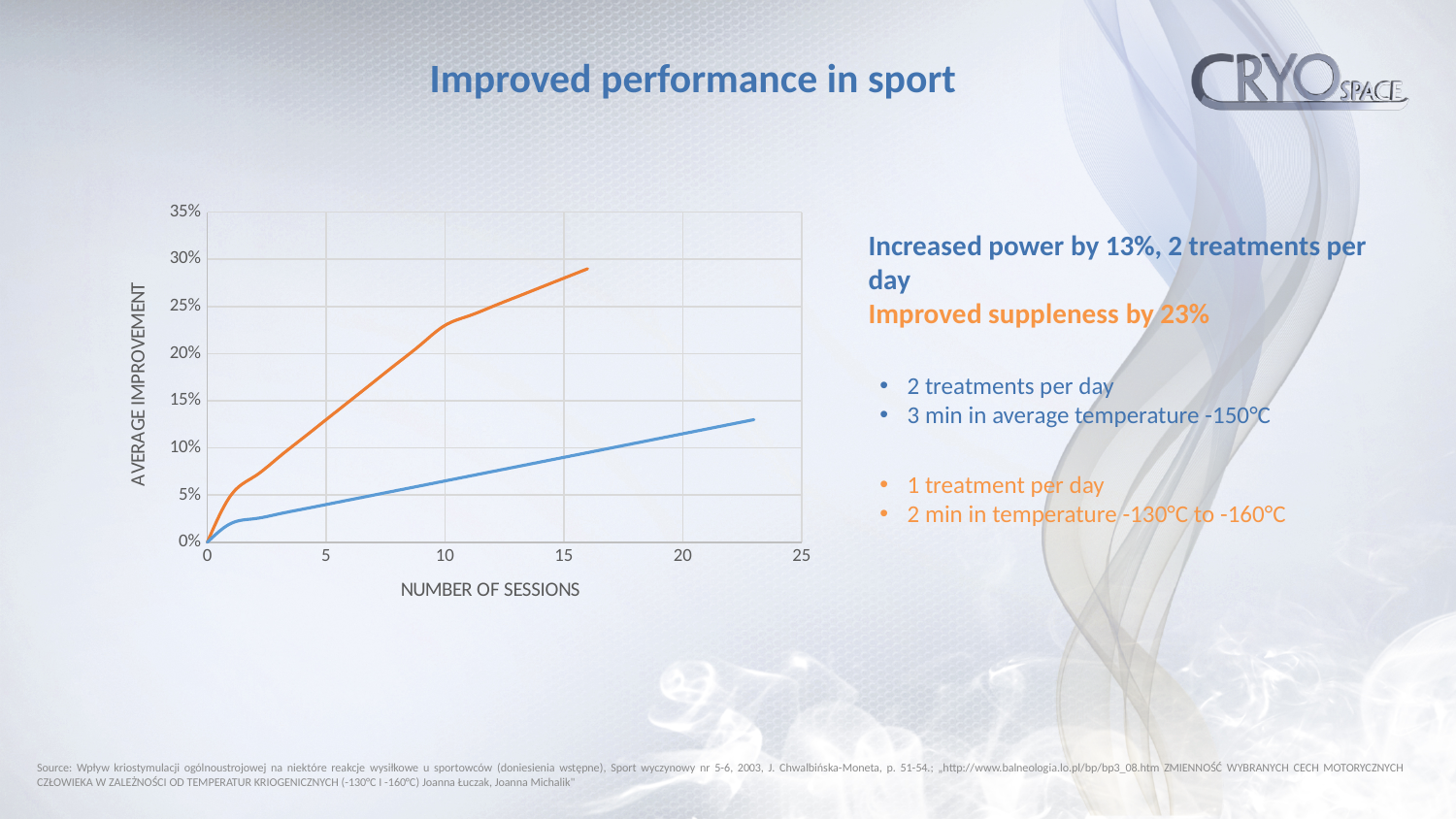
At 10 sessions, which line shows the higher average improvement, the orange or the blue? orange What is the title of the y axis of the chart? AVERAGE IMPROVEMENT Is the value of the blue line at 10 sessions greater or less than 10%? less How many lines are plotted on the chart? 2 What is the highest value shown on the y axis of the chart? 35% Is the value of the orange line at 15 sessions greater or less than 25%? greater Is the value of the blue line at 20 sessions greater or less than 15%? less What is the title of the x axis of the chart? NUMBER OF SESSIONS What kind of chart is shown on the slide? line chart Do the values of the blue line rise or fall as the number of sessions increases? rise Do the values of the orange line rise or fall as the number of sessions increases? rise